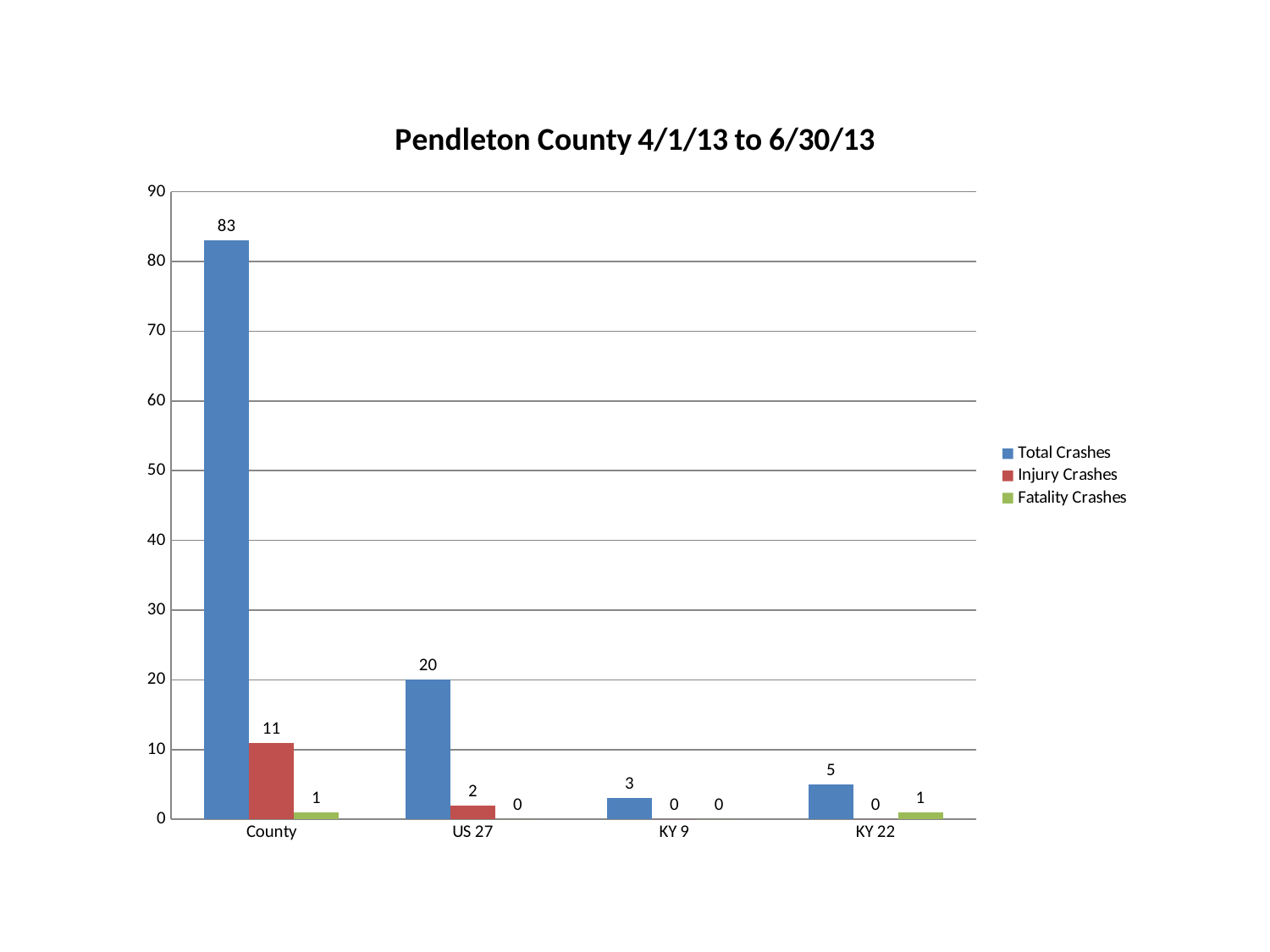
What is the title of the chart? Pendleton County 4/1/13 to 6/30/13 What kind of chart is shown on the slide? Bar chart What is the value of Injury Crashes for US 27? 2 Which is larger: Total Crashes for KY 22 or Total Crashes for KY 9? KY 22 How many categories are shown on the x axis? 4 How many series does the legend list? 3 Which category has the lowest Total Crashes? KY 9 Which category has the highest Total Crashes? County What is the value of Total Crashes for KY 9? 3 What is the value of Fatality Crashes for KY 22? 1 What is the value of Total Crashes for County? 83 What is the difference between Total Crashes for County and Total Crashes for US 27? 63